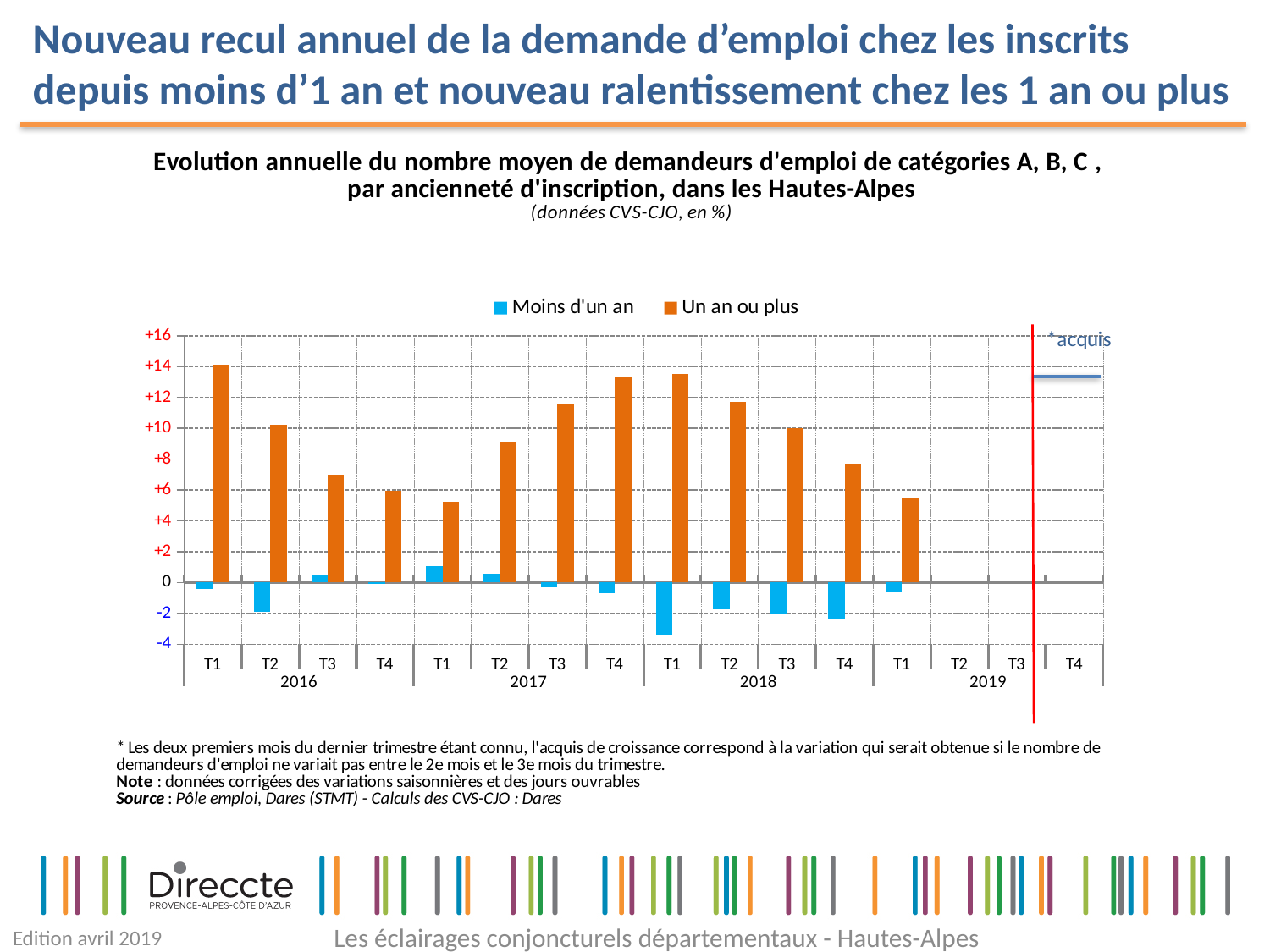
Is the value for 'Un an ou plus' in T1 2017 greater or less than +6? less How many quarters have bars plotted on the chart? 13 For the series 'Moins d'un an', which quarter has the lowest value? T1 2018 Is the value for 'Un an ou plus' in T4 2017 greater or less than +12? greater For the series 'Un an ou plus', do the values rise or fall from T1 2018 to T1 2019? Fall What are the two series named in the legend? Moins d'un an; Un an ou plus Is the value for 'Un an ou plus' in T1 2016 greater or less than +12? greater For the series 'Un an ou plus', which is larger: T2 2016 or T3 2016? T2 2016 Which colour represents the series 'Un an ou plus'? Orange How many series does the legend list? 2 What kind of chart is shown on the slide? Bar chart